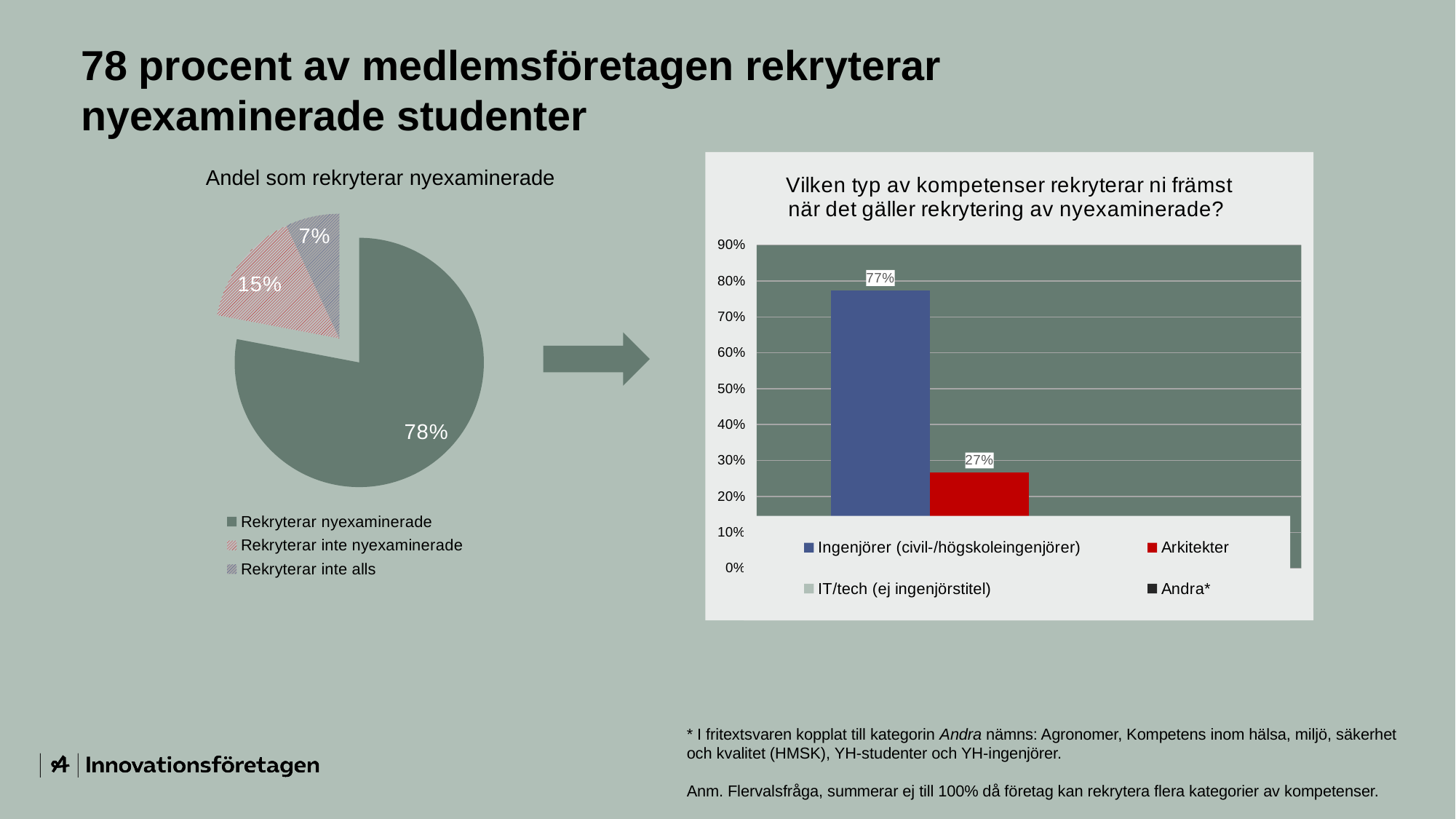
In the chart 'Vilken typ av kompetenser rekryterar ni främst när det gäller rekrytering av nyexaminerade?', what is the difference between 'Ingenjörer (civil-/högskoleingenjörer)' and 'Arkitekter'? 50% In the chart 'Vilken typ av kompetenser rekryterar ni främst när det gäller rekrytering av nyexaminerade?', what is the value for 'Ingenjörer (civil-/högskoleingenjörer)'? 77% What type of chart is the chart on the left of the slide? Pie chart In the pie chart 'Andel som rekryterar nyexaminerade', what share is 'Rekryterar inte nyexaminerade'? 15% In the pie chart 'Andel som rekryterar nyexaminerade', what share is 'Rekryterar inte alls'? 7% In the pie chart 'Andel som rekryterar nyexaminerade', what share is 'Rekryterar nyexaminerade'? 78% In the pie chart 'Andel som rekryterar nyexaminerade', which category has the largest slice? Rekryterar nyexaminerade In the chart 'Vilken typ av kompetenser rekryterar ni främst när det gäller rekrytering av nyexaminerade?', how many series does the legend list? 4 In the pie chart 'Andel som rekryterar nyexaminerade', how many slices are there? 3 In the pie chart 'Andel som rekryterar nyexaminerade', what is the difference between 'Rekryterar inte nyexaminerade' and 'Rekryterar inte alls'? 8% In the pie chart 'Andel som rekryterar nyexaminerade', which category has the smallest slice? Rekryterar inte alls In the chart 'Vilken typ av kompetenser rekryterar ni främst när det gäller rekrytering av nyexaminerade?', what is the value for 'Arkitekter'? 27%